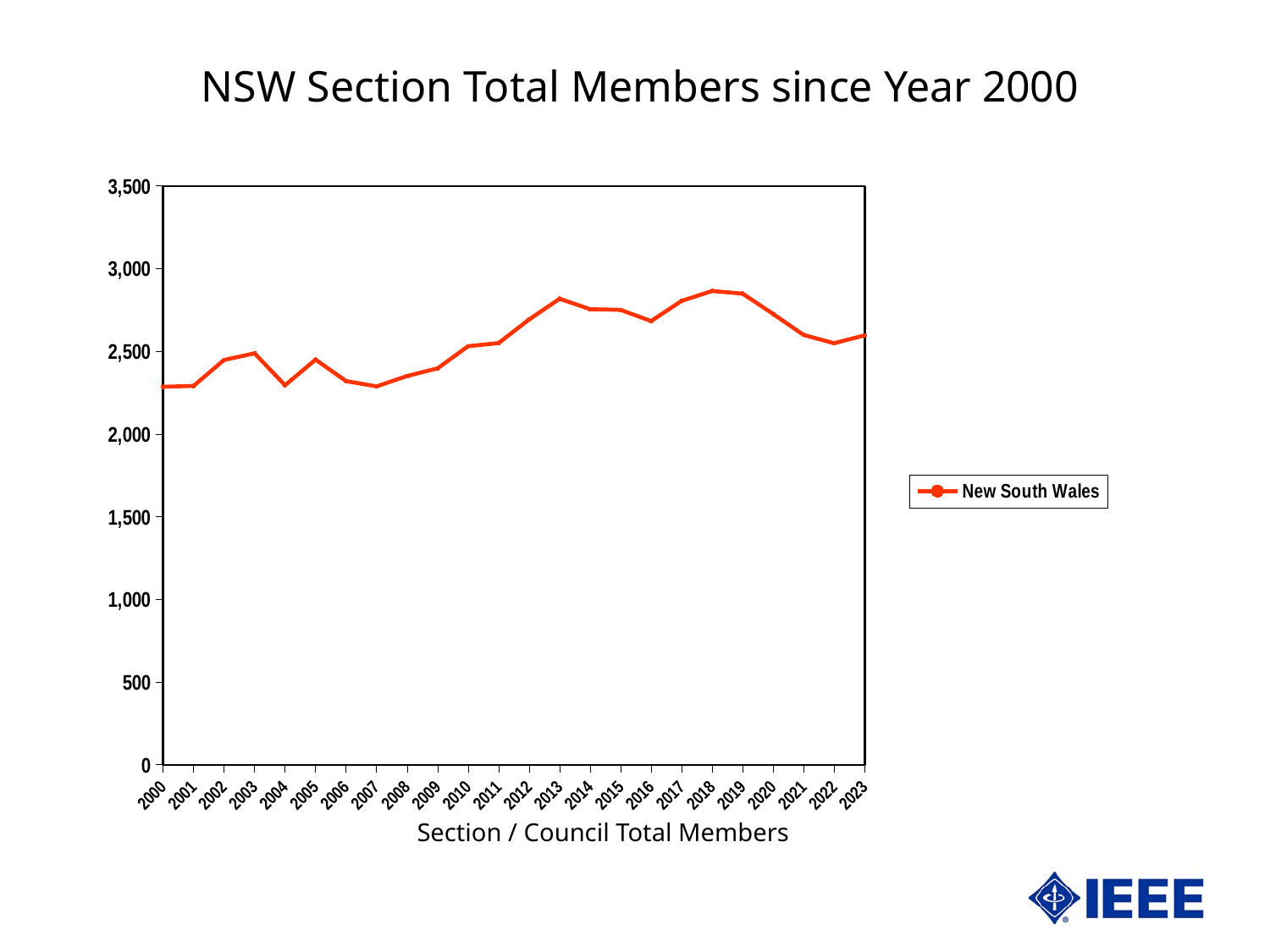
What series name appears in the legend? New South Wales How many years are plotted along the x axis? 24 Is the value for 2007 greater or less than 2,500? less Which year has the larger value, 2018 or 2022? 2018 Do the values rise or fall from 2019 to 2022? fall Which year has the larger value, 2013 or 2000? 2013 Is the value for 2013 greater or less than 2,500? greater How many series does the legend list? 1 What kind of chart is shown on the slide? Line chart Is the value for 2000 greater or less than 2,500? less What is the title of the chart? NSW Section Total Members since Year 2000